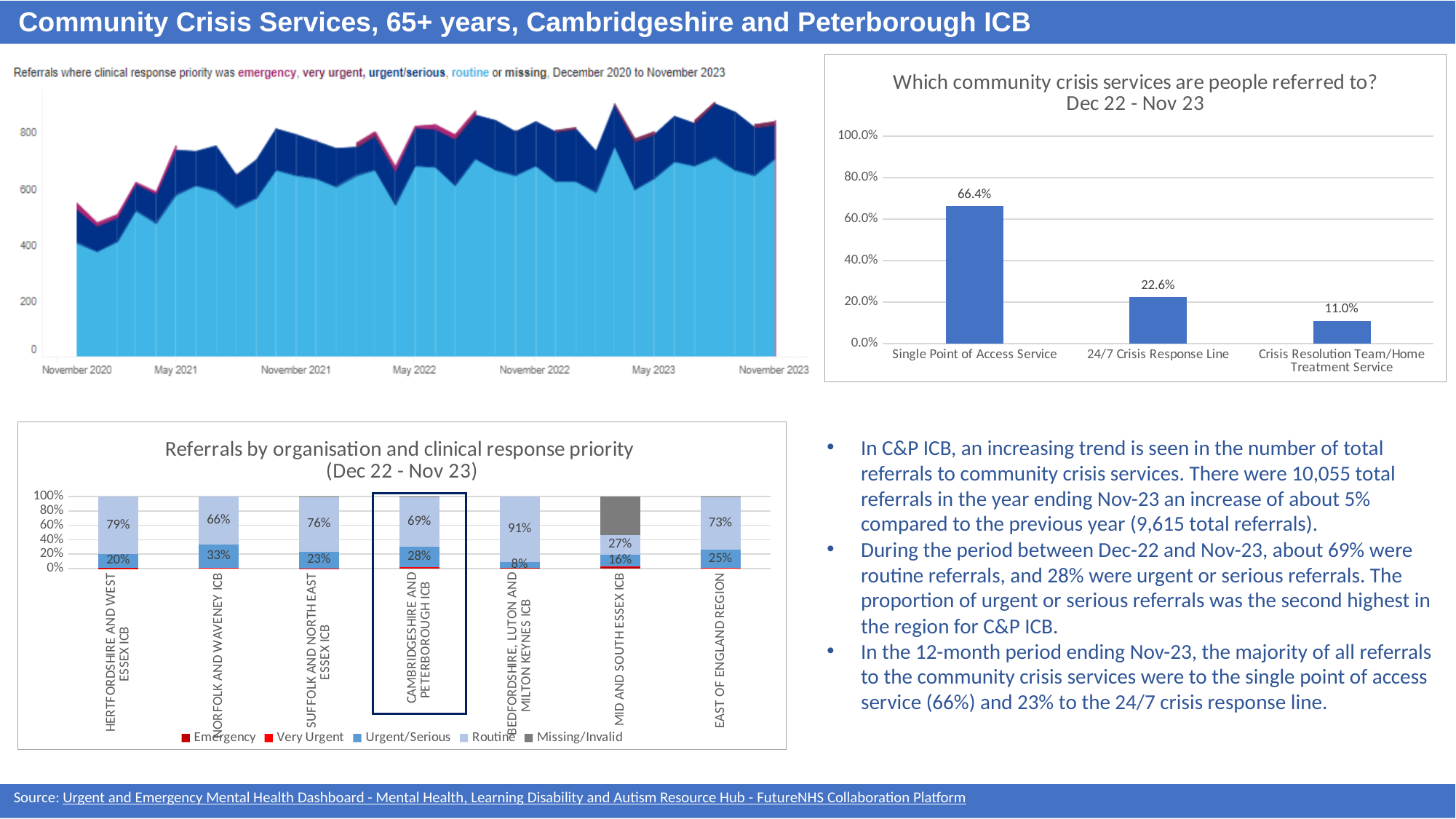
In the chart 'Which community crisis services are people referred to?', what is the difference between Single Point of Access Service and 24/7 Crisis Response Line? 43.8% In the chart 'Referrals by organisation and clinical response priority', what is the Routine percentage for Cambridgeshire and Peterborough ICB? 69% What kind of chart is the top-left chart showing referrals by clinical response priority from December 2020 to November 2023? Stacked area chart How many series does the legend list in the chart 'Referrals by organisation and clinical response priority'? 5 In the chart 'Which community crisis services are people referred to?', what is the value for Single Point of Access Service? 66.4% In the chart 'Referrals by organisation and clinical response priority', what is the Urgent/Serious percentage for Norfolk and Waveney ICB? 33% In the top-left chart of referrals by clinical response priority, do total referrals generally rise or fall from November 2020 to November 2023? Rise How many categories are shown in the chart 'Which community crisis services are people referred to?' 3 In the chart 'Referrals by organisation and clinical response priority', is the Urgent/Serious percentage larger for Suffolk and North East Essex ICB or for Cambridgeshire and Peterborough ICB? Cambridgeshire and Peterborough ICB In the chart 'Which community crisis services are people referred to?', what is the value for Crisis Resolution Team/Home Treatment Service? 11.0% In the chart 'Which community crisis services are people referred to?', which service has the lowest value? Crisis Resolution Team/Home Treatment Service In the chart 'Referrals by organisation and clinical response priority', which organisation has the highest Routine percentage? Bedfordshire, Luton and Milton Keynes ICB